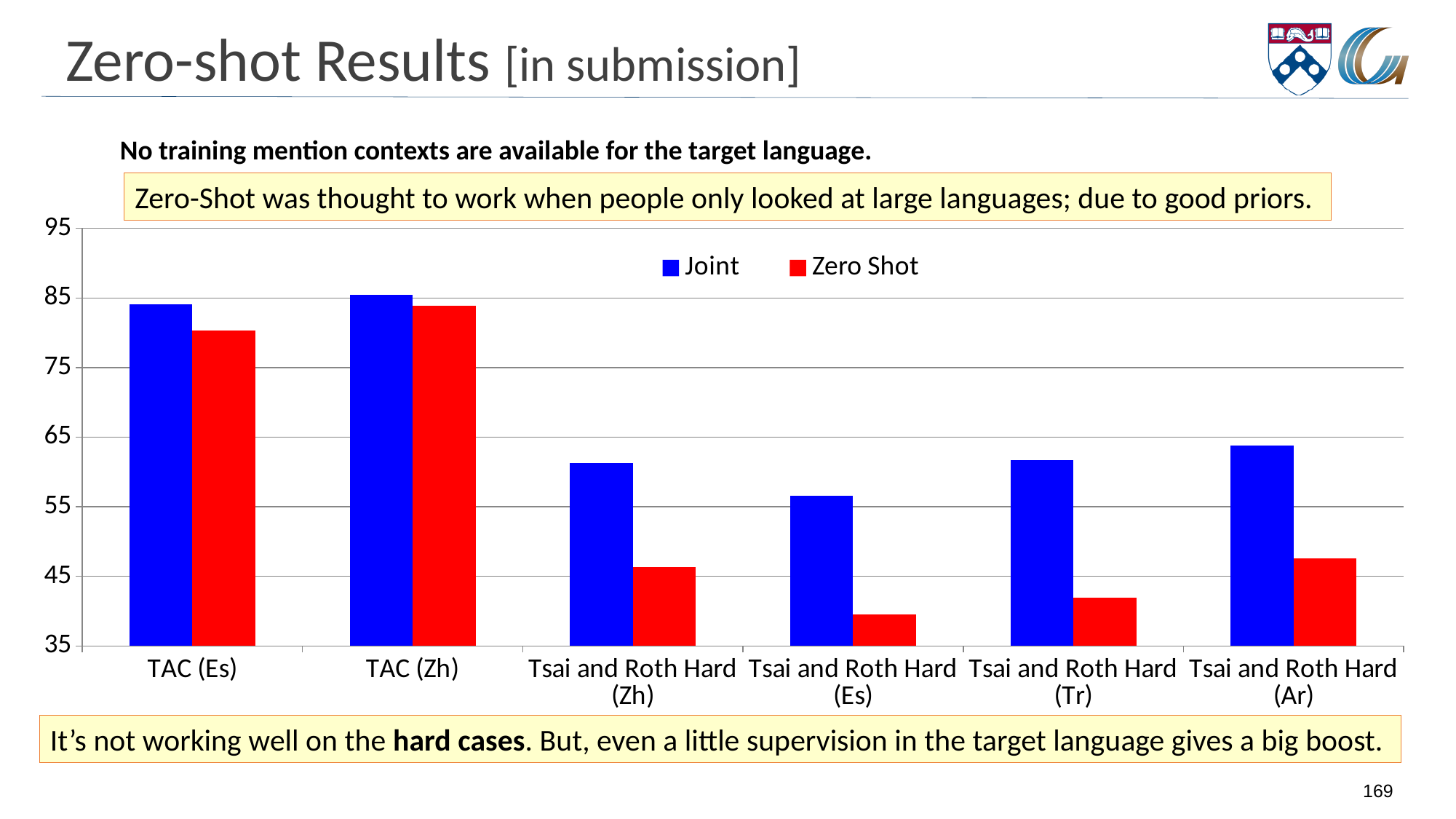
Which category has the highest Zero Shot value? TAC (Zh) How many categories are shown on the x axis? 6 Is the Joint value for Tsai and Roth Hard (Ar) greater or less than 55? greater Which category has the highest Joint value? TAC (Zh) What colour are the Joint bars in the chart? blue What kind of chart is shown on the slide? bar chart Which category has the lowest Zero Shot value? Tsai and Roth Hard (Es) Is the Zero Shot value for Tsai and Roth Hard (Es) greater or less than 45? less For Tsai and Roth Hard (Zh), which is larger: Joint or Zero Shot? Joint How many series does the legend list? 2 Is the Zero Shot value for TAC (Es) greater or less than 75? greater